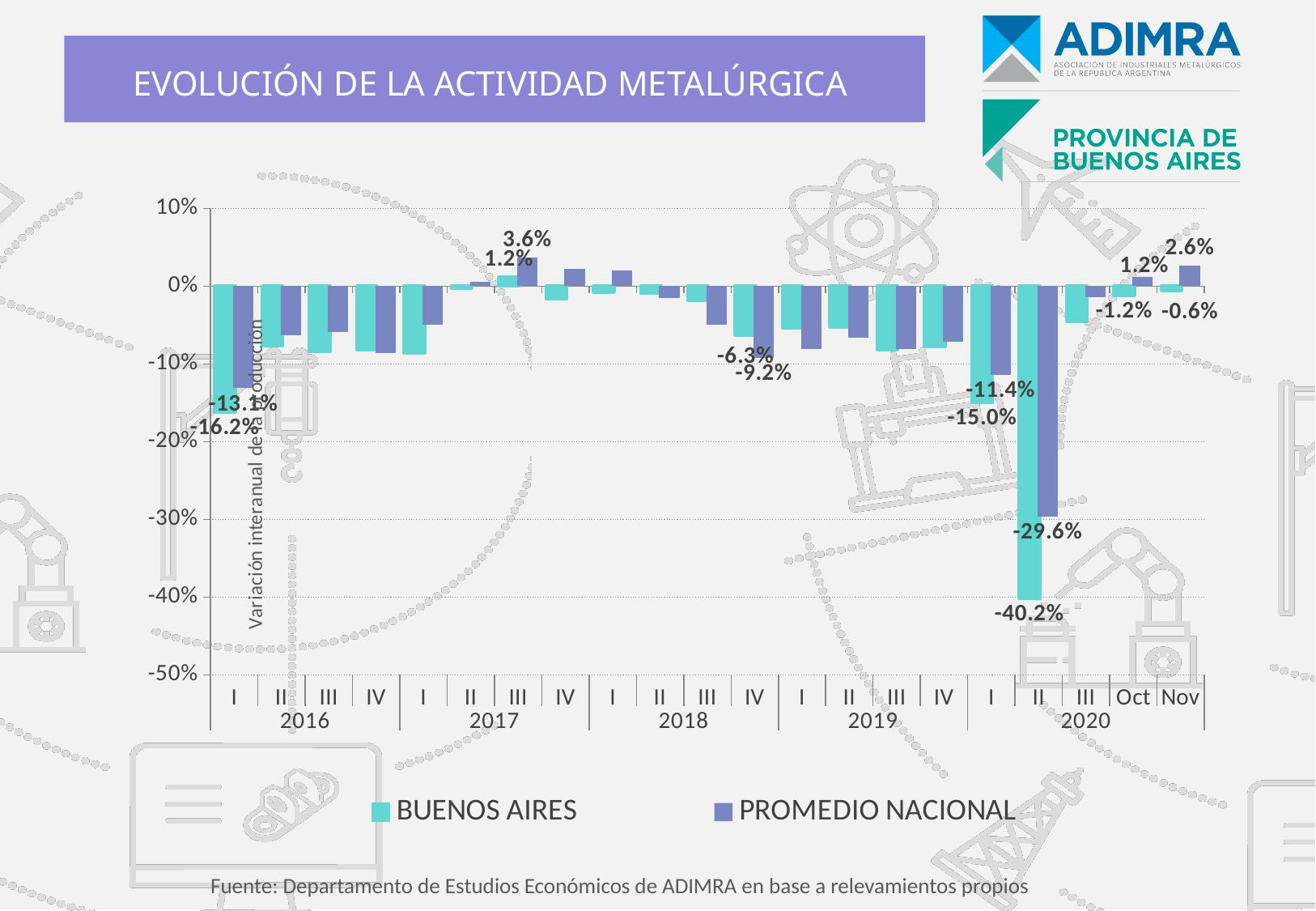
What is the value for BUENOS AIRES in quarter II of 2020? -40.2% What is the difference between the BUENOS AIRES and PROMEDIO NACIONAL values in quarter II of 2020? 10.6 percentage points How many series does the legend list? 2 In quarter IV of 2018, which series has the lower value, BUENOS AIRES or PROMEDIO NACIONAL? PROMEDIO NACIONAL What is the value for PROMEDIO NACIONAL in Nov 2020? 2.6% How many periods are shown along the x axis? 21 What kind of chart is shown on the slide? Bar chart What is the value for PROMEDIO NACIONAL in quarter II of 2020? -29.6% In which period does PROMEDIO NACIONAL reach its highest value? III 2017 What is the title of the chart? EVOLUCIÓN DE LA ACTIVIDAD METALÚRGICA In which period does BUENOS AIRES reach its lowest value? II 2020 What is the value for BUENOS AIRES in quarter I of 2016? -16.2%